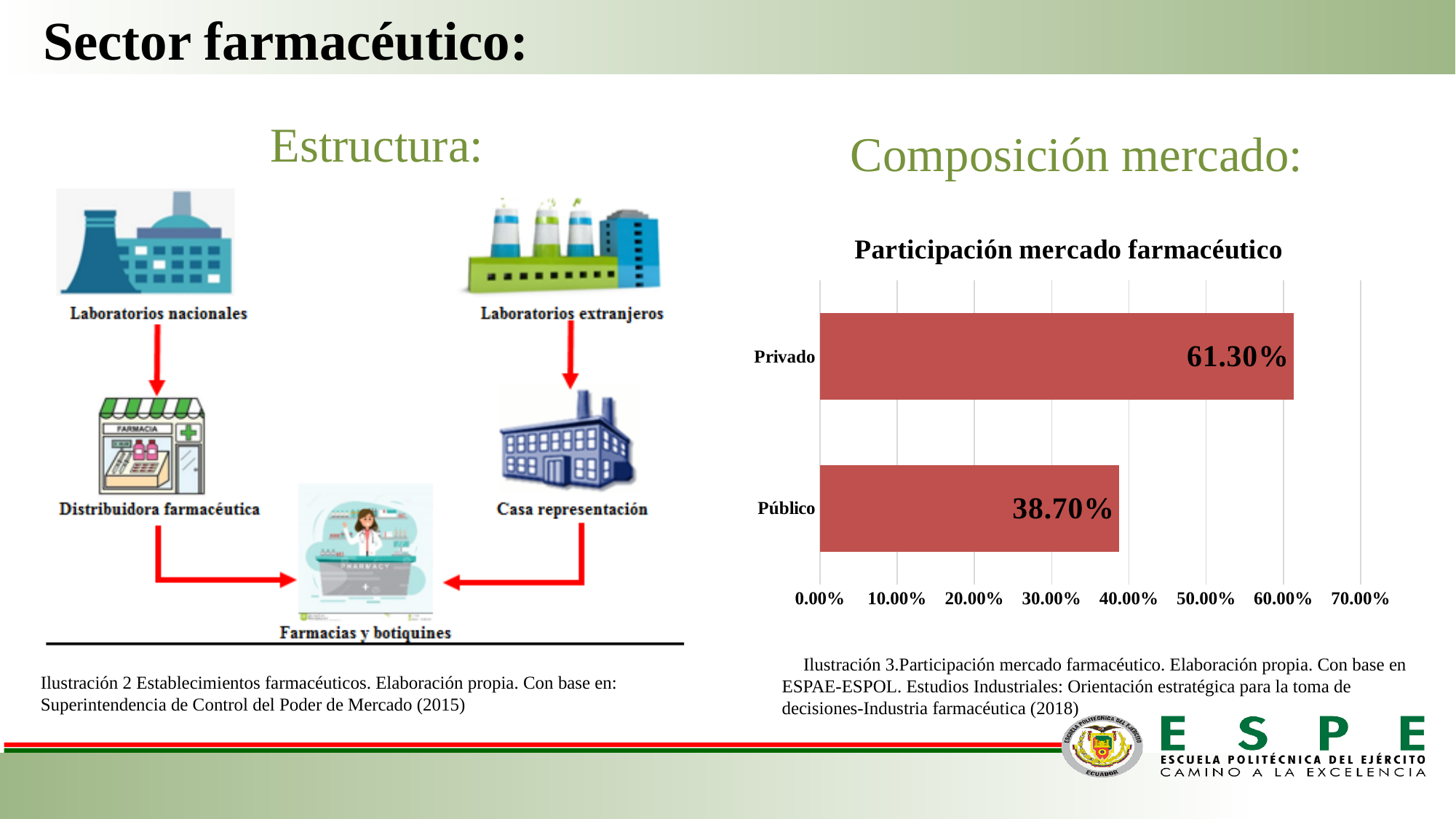
What kind of chart is the Participación mercado farmacéutico chart? bar chart What is the difference between the Privado and Público values in the Participación mercado farmacéutico chart? 22.60% Is the value for Privado greater or less than 60.00% in the Participación mercado farmacéutico chart? greater What is the title of the chart on the slide? Participación mercado farmacéutico Is the value for Público greater or less than 40.00% in the Participación mercado farmacéutico chart? less What is the value for Privado in the Participación mercado farmacéutico chart? 61.30% In the Participación mercado farmacéutico chart, which is larger: Privado or Público? Privado Which category has the lowest value in the Participación mercado farmacéutico chart? Público How many categories are shown in the Participación mercado farmacéutico chart? 2 What is the value for Público in the Participación mercado farmacéutico chart? 38.70% Which category has the highest value in the Participación mercado farmacéutico chart? Privado What is the highest value shown on the x axis of the Participación mercado farmacéutico chart? 70.00%